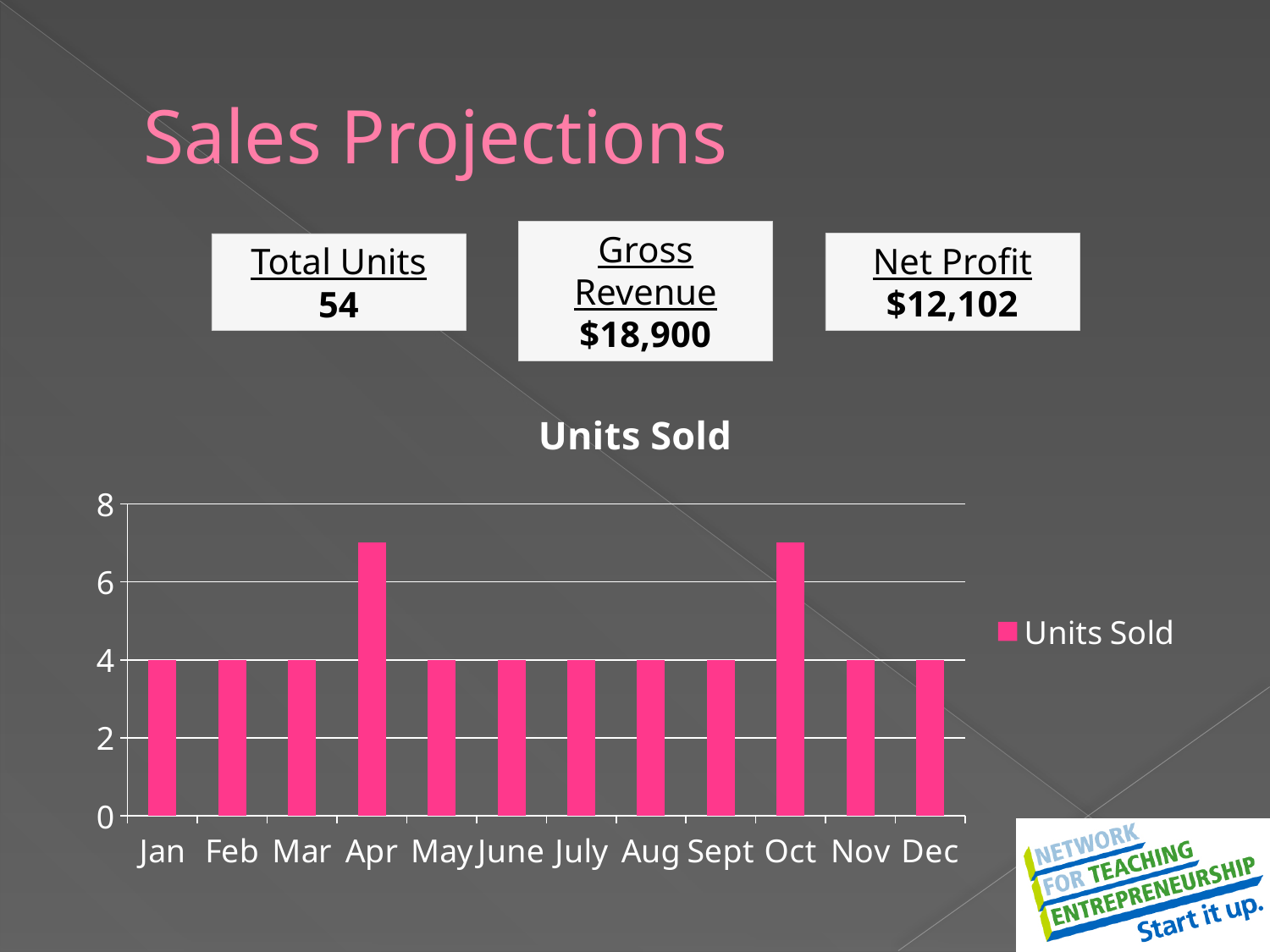
What is the value for June in the Units Sold chart? 4 How many series does the legend list? 1 Which is larger, the value for Apr or the value for Mar? Apr Which is larger, the value for Nov or the value for Oct? Oct Is the value for Apr greater or less than 6? greater What kind of chart is shown on the slide? bar chart What is the title of the chart? Units Sold How many months are shown on the x axis of the chart? 12 Is the value for Oct greater or less than 8? less Is the value for Sept greater or less than 6? less What is the value for Dec in the Units Sold chart? 4 What is the value for Jan in the Units Sold chart? 4